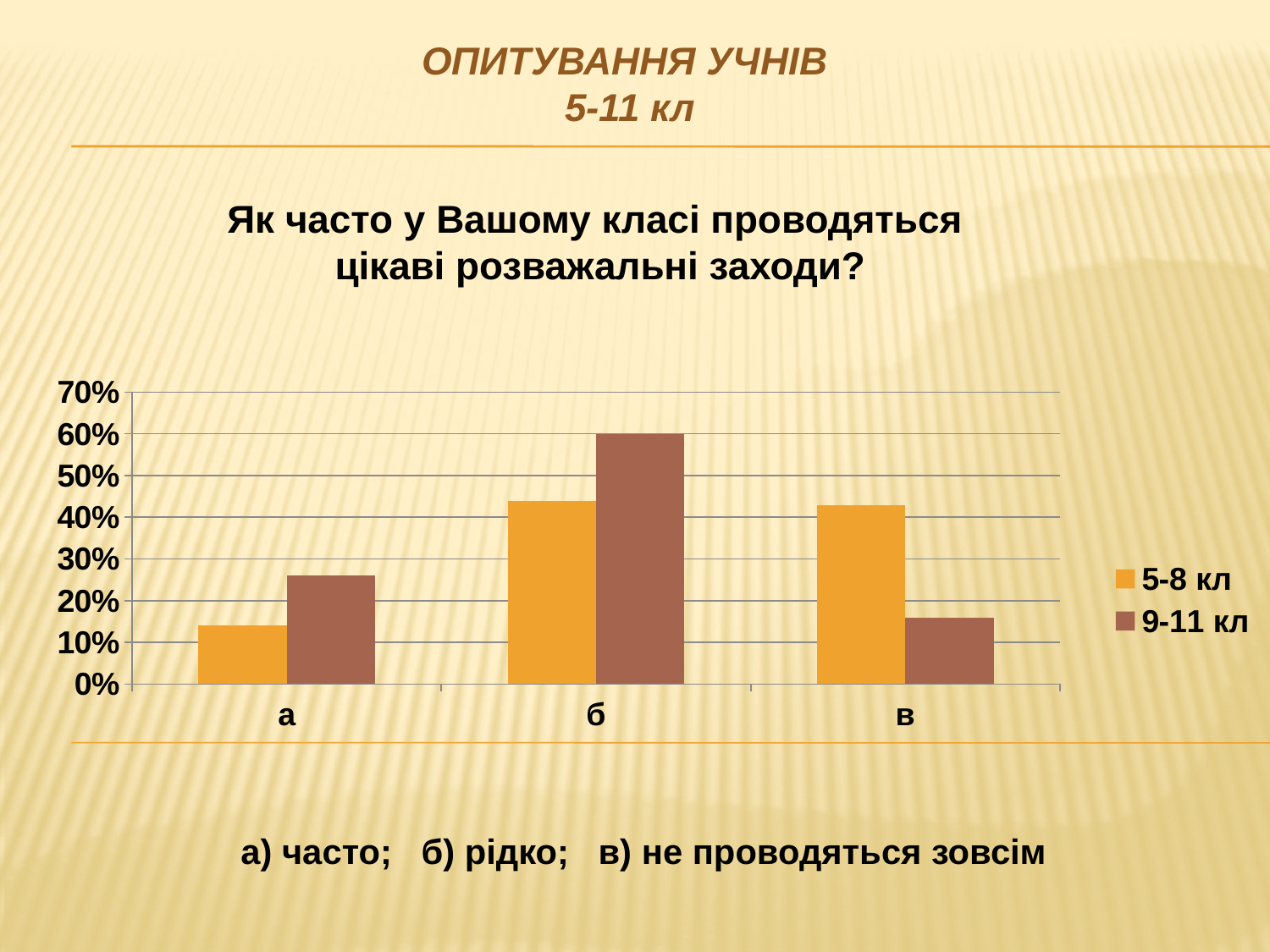
For the 9-11 кл series, which category has the lowest value? в How many categories are shown on the x axis of the chart? 3 For the 5-8 кл series, which category has the lowest value? а What kind of chart is shown on the slide? bar chart What is the value for 9-11 кл in category б? 60% In category а, which series has the larger value, 5-8 кл or 9-11 кл? 9-11 кл What are the two series named in the chart legend? 5-8 кл and 9-11 кл Is the value for 5-8 кл in category а greater or less than 20%? less In category в, which series has the larger value, 5-8 кл or 9-11 кл? 5-8 кл For the 9-11 кл series, which category has the highest value? б How many series does the chart legend list? 2 Is the value for 5-8 кл in category б greater or less than 40%? greater